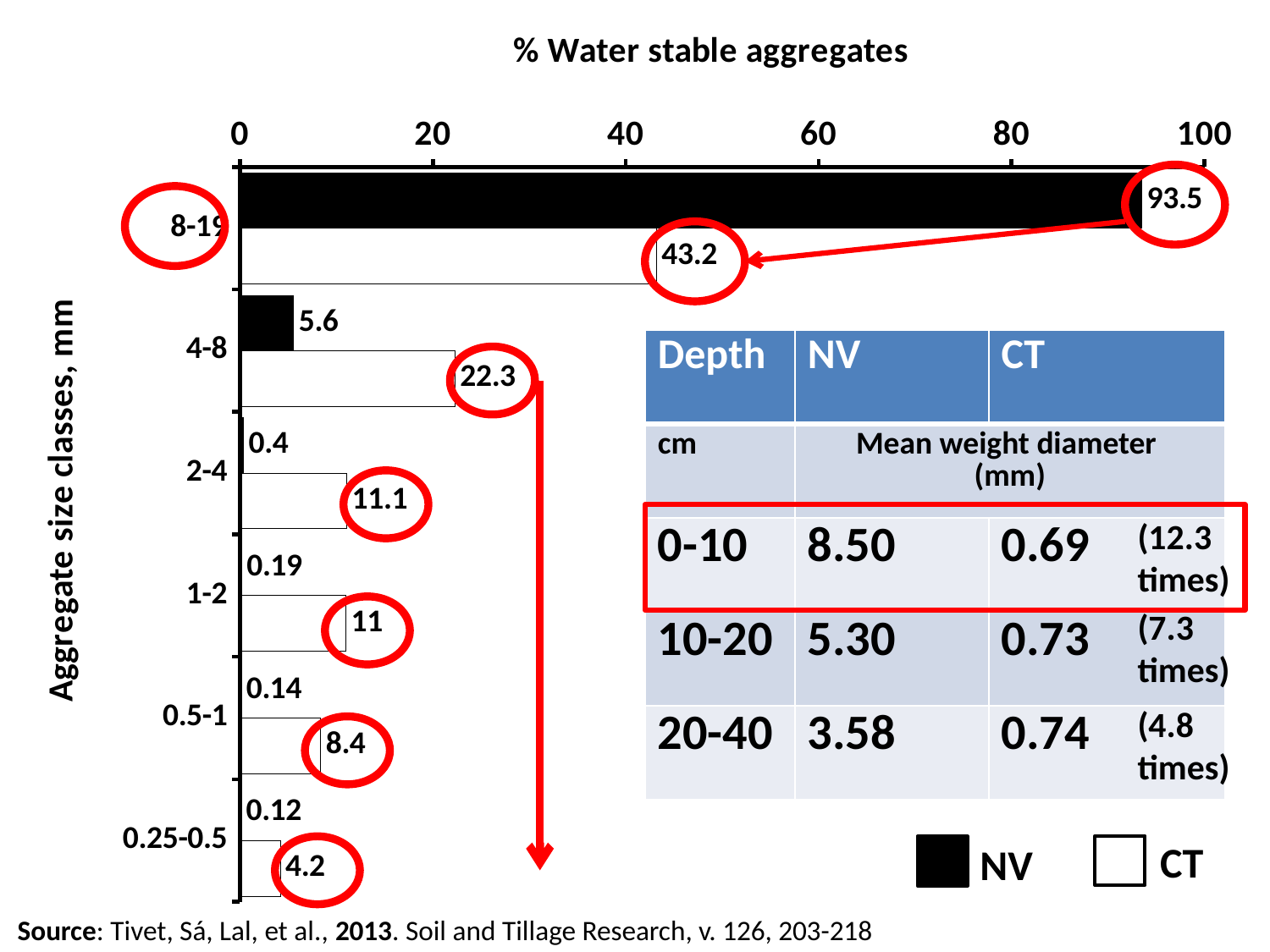
What is the NV value for the 8-19 mm aggregate size class? 93.5 What is the CT value for the 4-8 mm aggregate size class? 22.3 Which aggregate size class has the lowest NV value? 0.25-0.5 What is the title of the chart's horizontal axis? % Water stable aggregates What is the NV value for the 2-4 mm aggregate size class? 0.4 What is the difference between the NV and CT values for the 8-19 mm class? 50.3 For the 4-8 mm class, which is larger, the NV value or the CT value? CT What is the CT value for the 0.25-0.5 mm aggregate size class? 4.2 How many aggregate size classes are shown on the chart? 6 Which aggregate size class has the highest CT value? 8-19 What kind of chart is shown on the slide? bar chart How many series does the chart legend list? 2